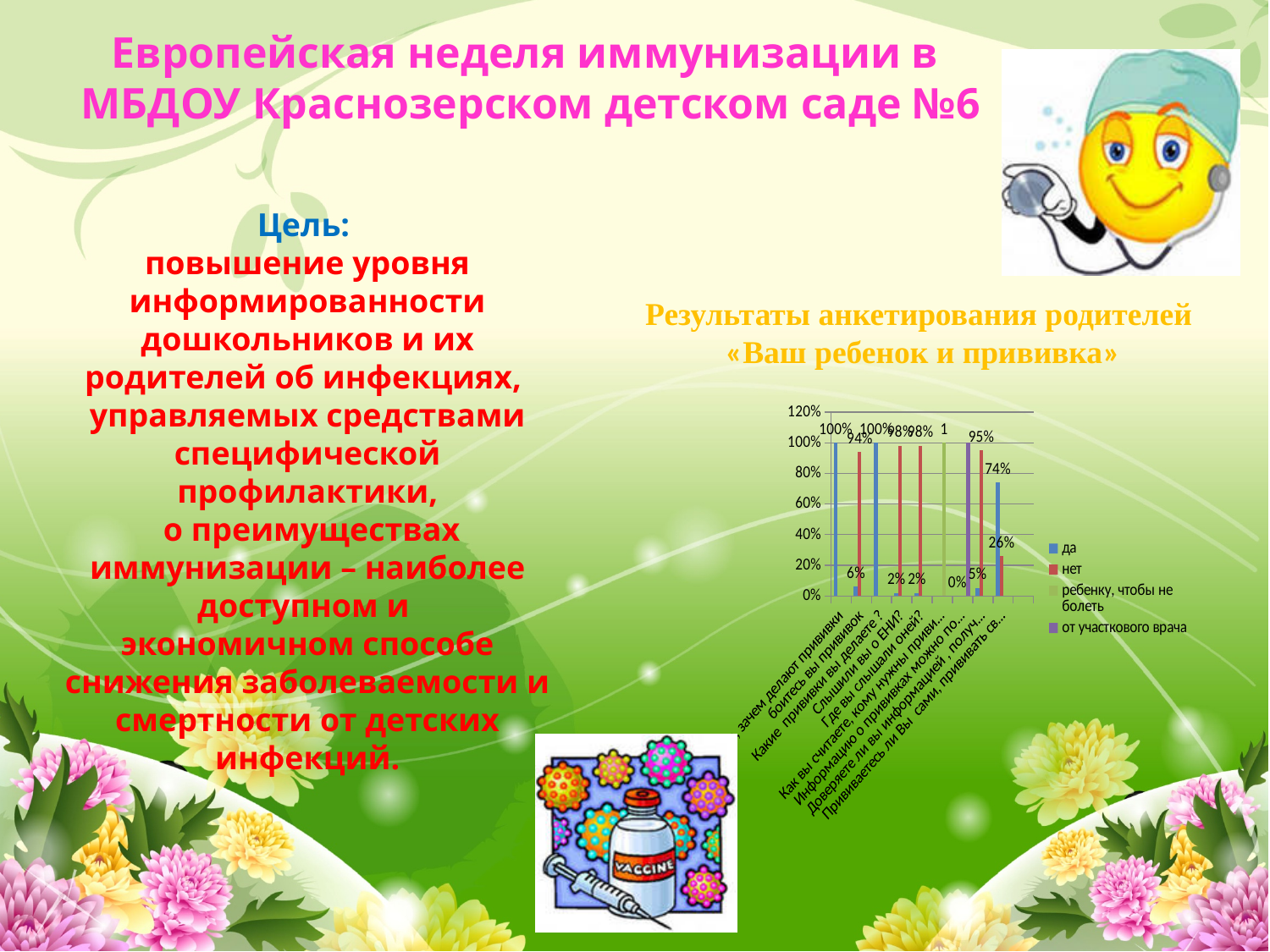
What are the first two entries in the chart's legend? да, нет How many series does the legend of the chart list? 4 What kind of chart is shown under the title «Результаты анкетирования родителей «Ваш ребенок и прививка»»? bar chart What is the highest percentage data label shown on the chart? 100% What is the highest tick value shown on the chart's vertical axis? 120% In the rightmost group of bars, what is the difference between the «да» and «нет» values? 48% In the rightmost group of bars, which is larger: «да» or «нет»? да How many category groups are plotted along the horizontal axis of the chart? 9 What is the lowest data label value shown on the chart? 0% In the rightmost group of bars on the chart, what is the value of the «да» bar? 74% What is the title of the chart on the slide? Результаты анкетирования родителей «Ваш ребенок и прививка» In the rightmost group of bars on the chart, what is the value of the «нет» bar? 26%